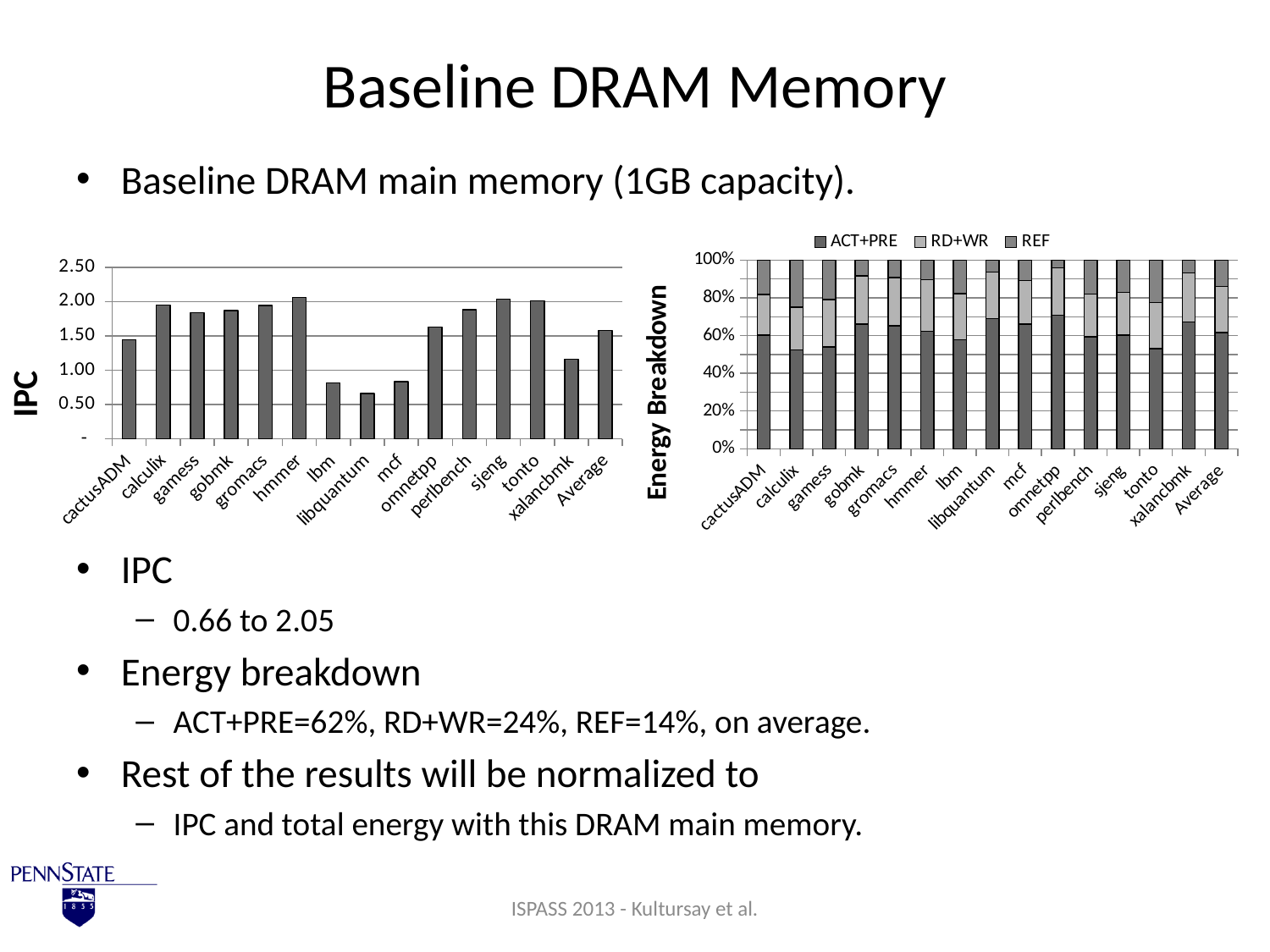
In the IPC chart, is the value for Average greater or less than 2.00? less In the Energy Breakdown chart, what is the total of the stacked bar for Average? 100% How many series does the legend of the Energy Breakdown chart list? 3 In the Energy Breakdown chart, is the ACT+PRE share for tonto greater or less than 60%? less In the IPC chart, which is larger, the IPC for gamess or for xalancbmk? gamess In the IPC chart, is the value for cactusADM greater or less than 1.00? greater How many benchmark categories are shown on the x axis of the IPC chart? 15 What are the three legend entries of the Energy Breakdown chart? ACT+PRE, RD+WR, REF What kind of chart is the left chart (IPC)? bar chart In the IPC chart, which is larger, the IPC for calculix or for lbm? calculix In the IPC chart, which category has the lowest IPC? libquantum